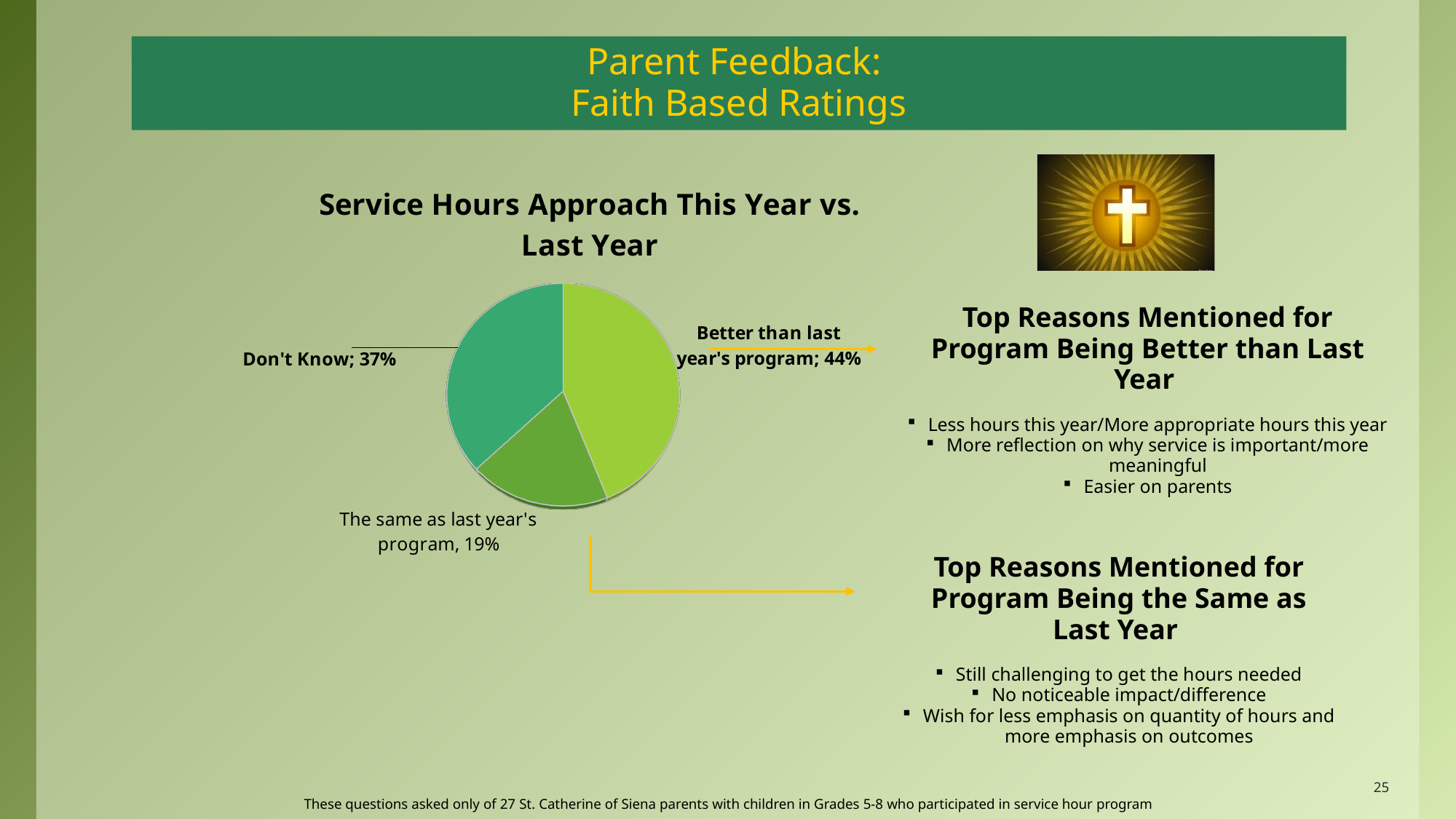
Which is larger: the share for "Don't Know" or the share for "The same as last year's program"? Don't Know What percentage of parents answered "Don't Know"? 37% Which response has the largest share of the pie? Better than last year's program What is the difference in percentage points between "Better than last year's program" and "Don't Know"? 7 What percentage of parents said the program was the same as last year's program? 19% What is the combined share of "Better than last year's program" and "The same as last year's program"? 63% What is the difference in percentage points between "Don't Know" and "The same as last year's program"? 18 What kind of chart is shown on the slide? pie chart How many slices does the pie chart have? 3 What is the title of the chart? Service Hours Approach This Year vs. Last Year What percentage of parents said the program was better than last year's program? 44% Which response has the smallest share of the pie? The same as last year's program